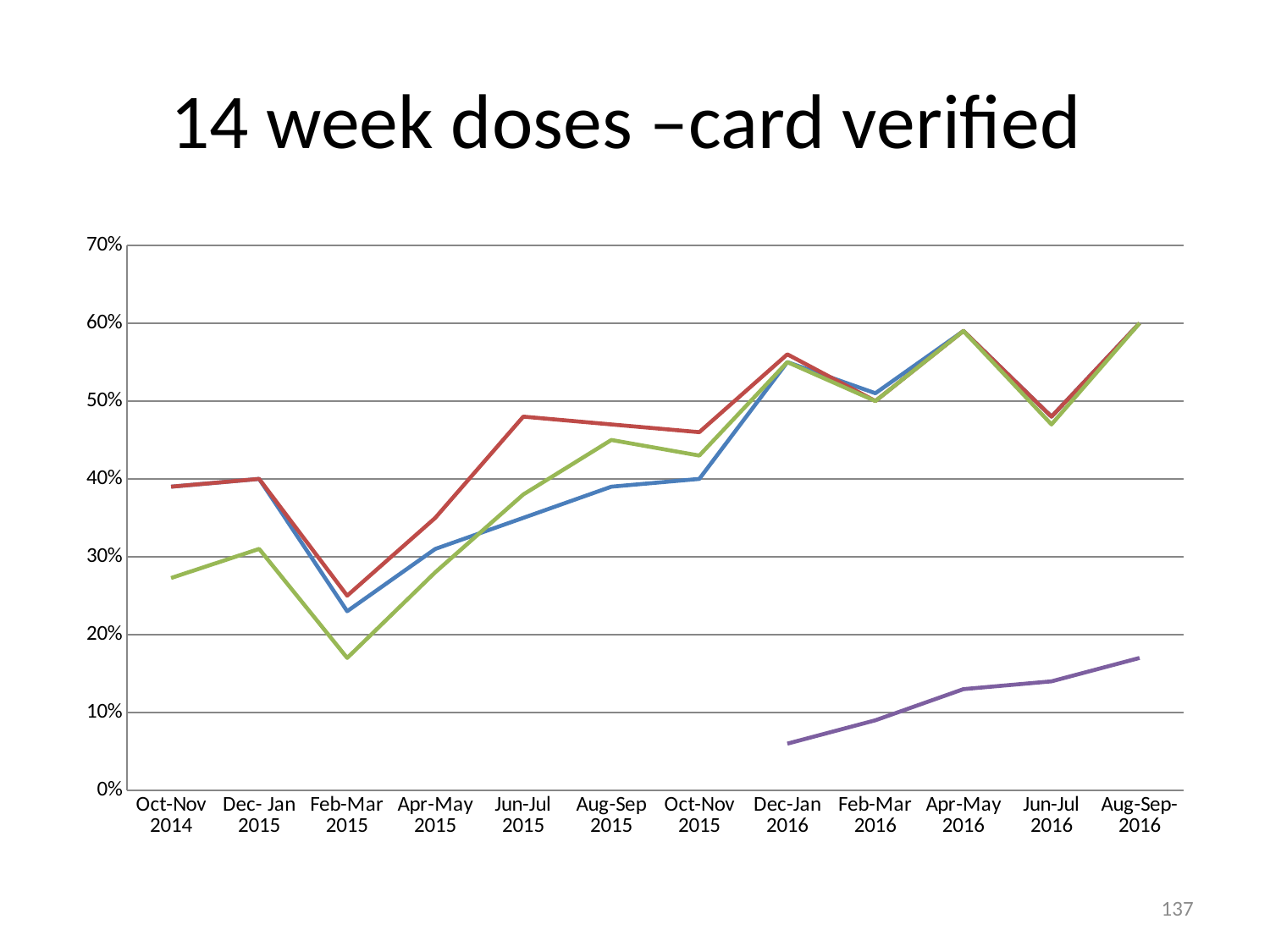
What kind of chart is shown on the slide? line chart Does the purple line rise or fall from Dec-Jan 2016 to Aug-Sep 2016? rise Is the value of the green line for Feb-Mar 2015 greater or less than 20%? less How many time periods are shown along the x axis? 12 Is the value of the purple line for Dec-Jan 2016 greater or less than 10%? less Is the value of the red line for Jun-Jul 2015 greater or less than 40%? greater At Oct-Nov 2014, which line has the higher value, the red line or the green line? red line What is the title of the chart? 14 week doses –card verified How many lines are plotted on the chart? 4 In which period does the purple line reach its highest value? Aug-Sep 2016 In which period does the green line reach its lowest value? Feb-Mar 2015